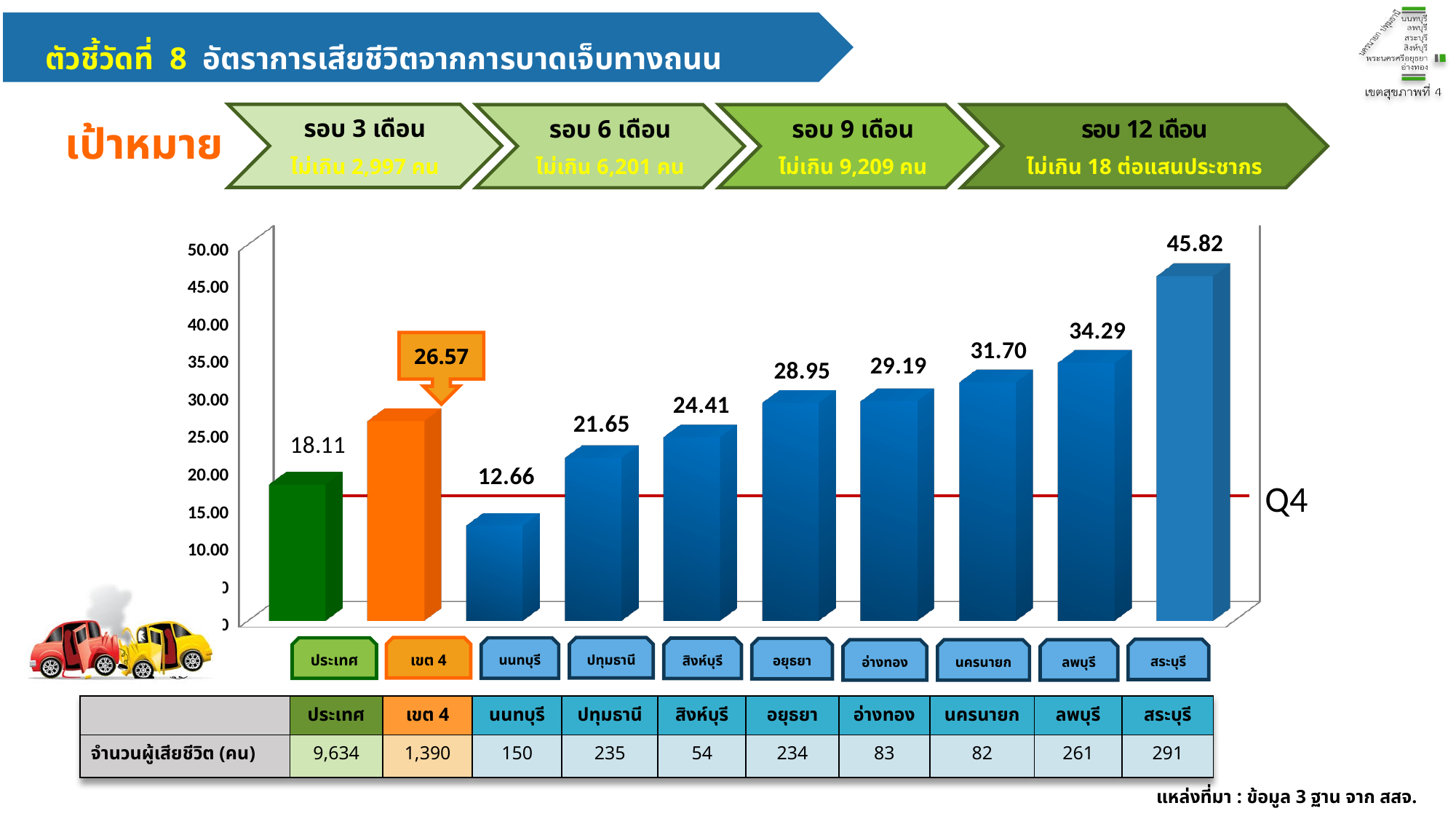
Which category has the highest value in the bar chart? สระบุรี Is the value for นนทบุรี in the bar chart greater or less than 15.00? less How many categories (bars) are shown in the bar chart? 10 What is the difference between the values for เขต 4 and ประเทศ in the bar chart? 8.46 Which has a larger value in the bar chart, ลพบุรี or นครนายก? ลพบุรี What is the difference between the values for สระบุรี and นนทบุรี in the bar chart? 33.16 What label is written next to the red horizontal line on the chart? Q4 What is the value shown for สระบุรี in the bar chart? 45.82 What is the value shown for ประเทศ in the bar chart? 18.11 What kind of chart is shown on the slide? bar chart Which category has the lowest value in the bar chart? นนทบุรี What is the value shown for เขต 4 in the bar chart? 26.57